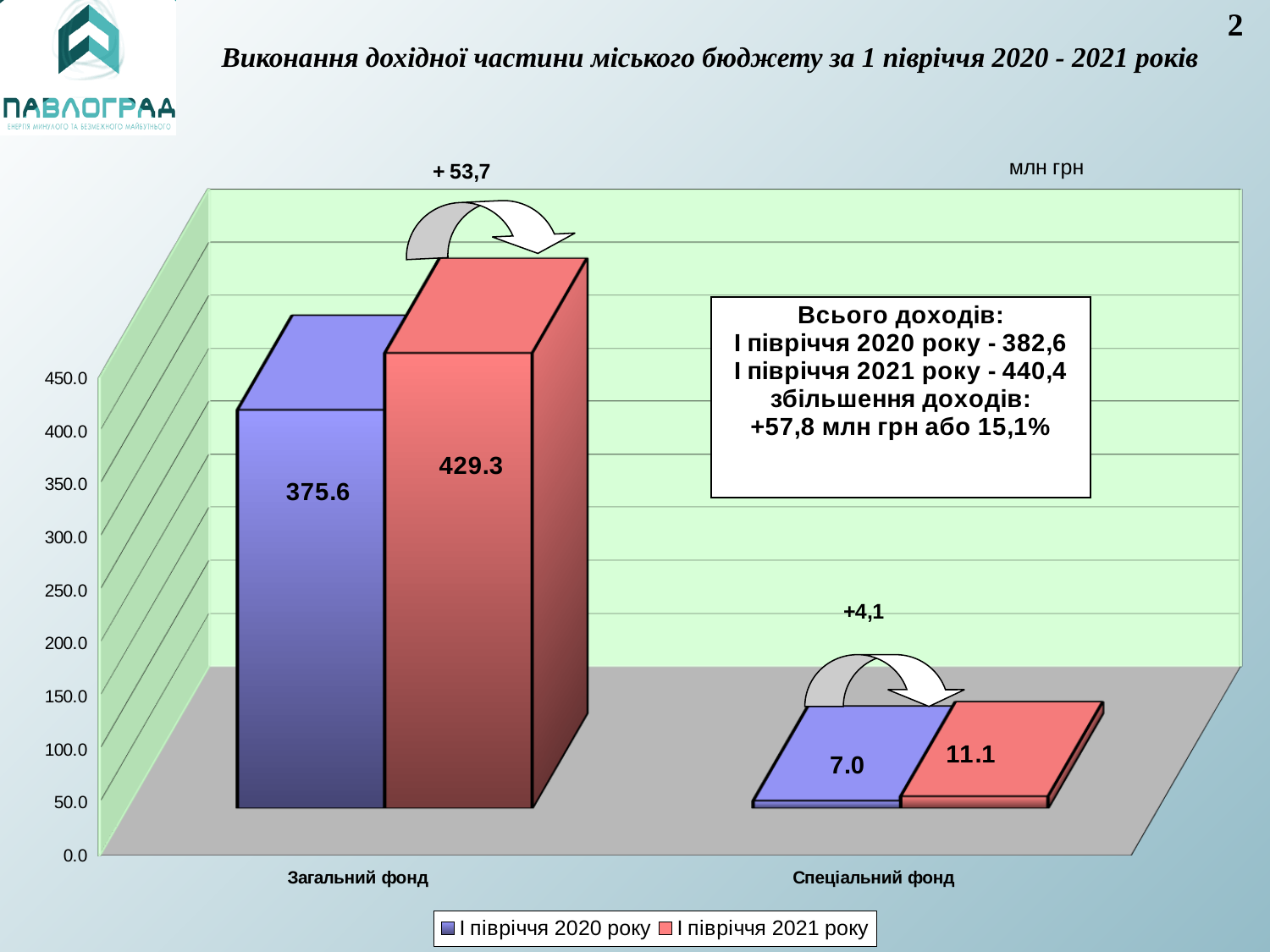
How many categories are shown on the x axis of the chart? 2 What is the difference between the І півріччя 2021 року and І півріччя 2020 року values for Спеціальний фонд? 4.1 What is the value for Загальний фонд in І півріччя 2021 року? 429.3 What is the value for Спеціальний фонд in І півріччя 2021 року? 11.1 What kind of chart is shown on the slide? Bar chart Which is larger for Спеціальний фонд: the І півріччя 2020 року value or the І півріччя 2021 року value? І півріччя 2021 року What is the value for Загальний фонд in І півріччя 2020 року? 375.6 How many series does the chart legend list? 2 Which category has the lowest value in І півріччя 2020 року? Спеціальний фонд Which category has the highest value in І півріччя 2021 року? Загальний фонд What is the difference between the І півріччя 2021 року and І півріччя 2020 року values for Загальний фонд? 53.7 What is the value for Спеціальний фонд in І півріччя 2020 року? 7.0